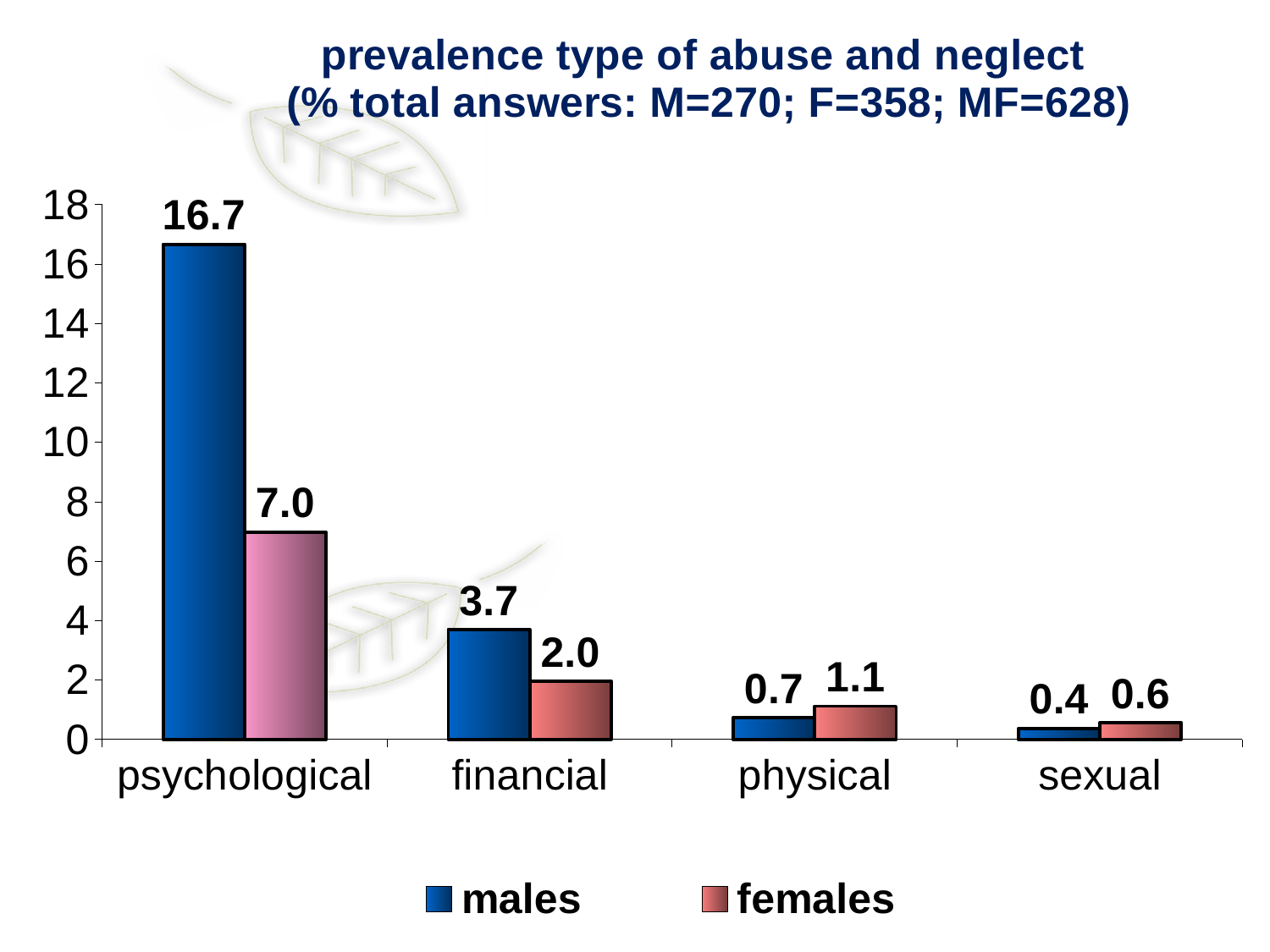
What is the value for females in the physical category? 1.1 Which category has the highest value for males? psychological What is the value for males in the psychological category? 16.7 How many categories are shown on the x axis? 4 What is the difference between the males and females values in the psychological category? 9.7 What is the value for males in the sexual category? 0.4 Which category has the lowest value for females? sexual Which is larger in the physical category, the value for males or for females? females How many series does the legend list? 2 What is the value for females in the financial category? 2.0 Do the values for males rise or fall from psychological to sexual along the x axis? fall What kind of chart is shown on the slide? bar chart